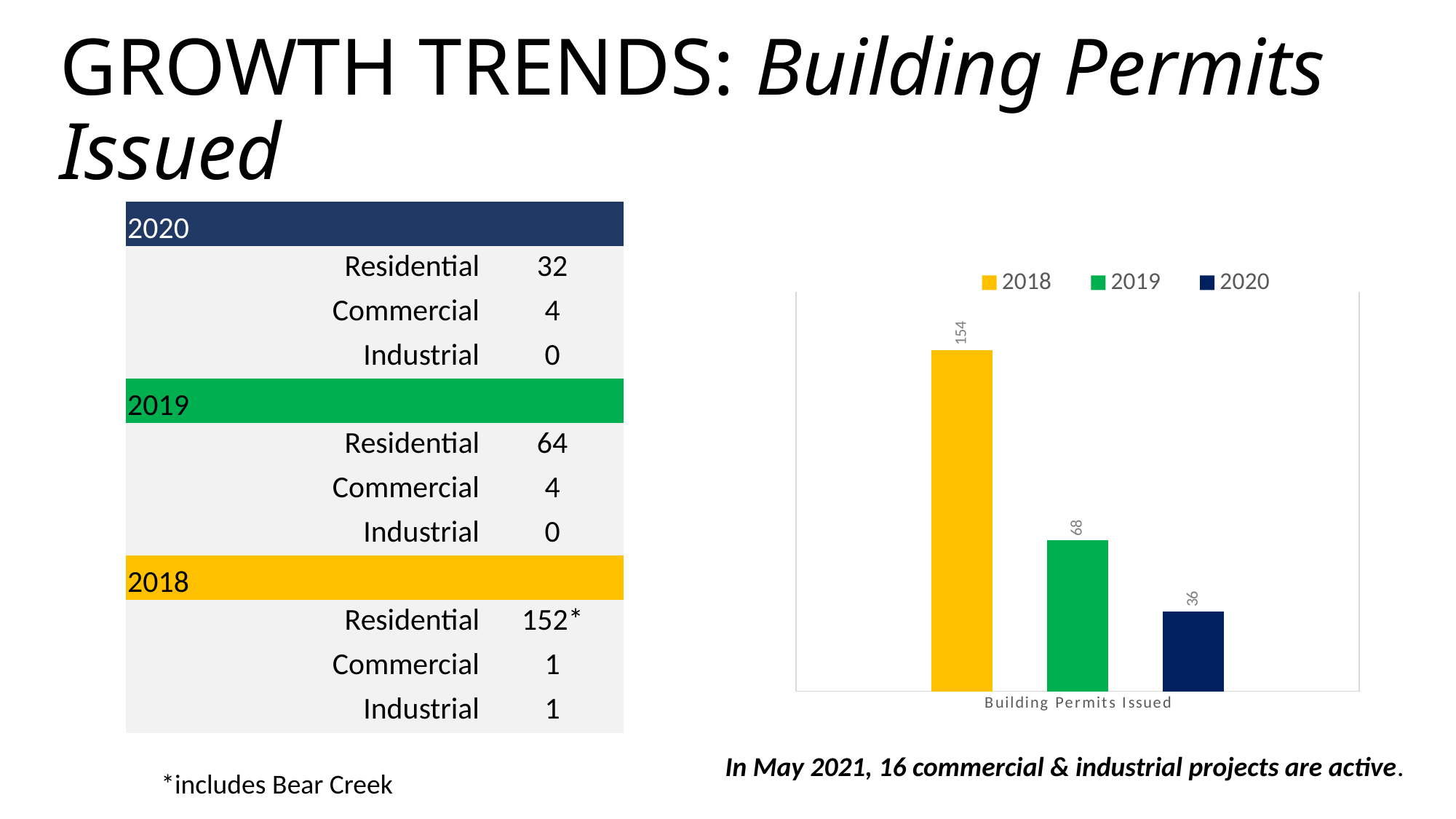
What is the value of the 2020 bar in the Building Permits Issued chart? 36 Do the values in the chart rise or fall from 2018 to 2020? Fall Which year has the highest number of building permits issued in the chart? 2018 What is the value of the 2018 bar in the Building Permits Issued chart? 154 What is the difference between the 2018 and 2019 bars in the chart? 86 How many series does the chart legend list? 3 Which is larger in the chart, the 2019 bar or the 2020 bar? 2019 What is the category label shown under the bars in the chart? Building Permits Issued What is the difference between the 2019 and 2020 bars in the chart? 32 What kind of chart is shown on the slide? Bar chart What is the value of the 2019 bar in the Building Permits Issued chart? 68 Which year has the lowest number of building permits issued in the chart? 2020